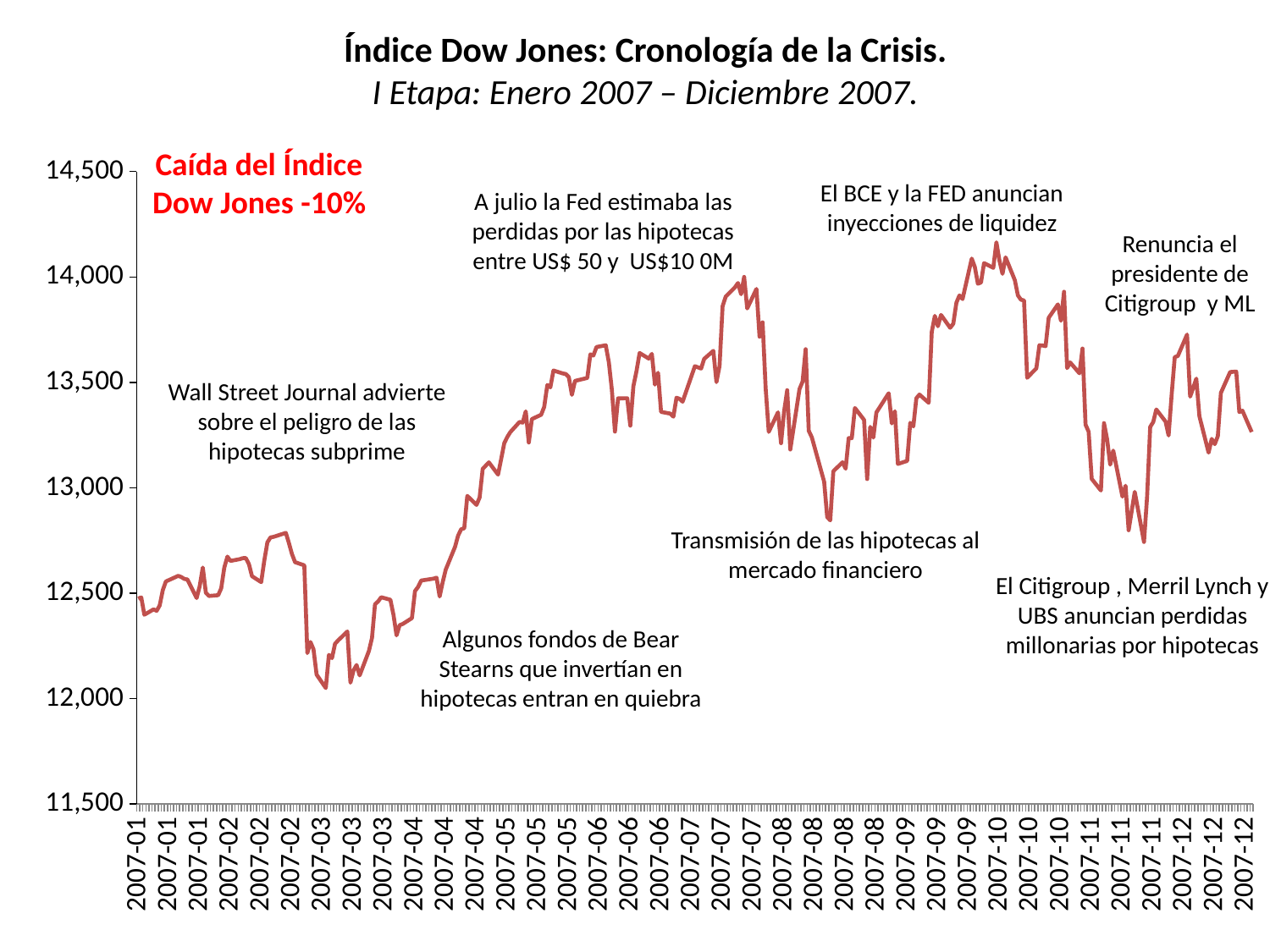
What is the title of the chart on the slide? Índice Dow Jones: Cronología de la Crisis. I Etapa: Enero 2007 – Diciembre 2007. Is the lowest value of the index in March 2007 greater or less than 12,500? less Does the index rise or fall from its October 2007 peak to late November 2007? fall Does the index generally rise or fall between April 2007 and July 2007? rise In which month does the index reach its highest value on the chart? 2007-10 Is the low point of the index in late November 2007 greater or less than 13,000? less How many lines (data series) are plotted on the chart? 1 In which month does the index reach its lowest value on the chart? 2007-03 Is the peak value of the index reached in October 2007 greater or less than 14,000? greater According to the red annotation on the chart, by what percentage did the Dow Jones index fall? -10% What kind of chart is shown on the slide? line chart